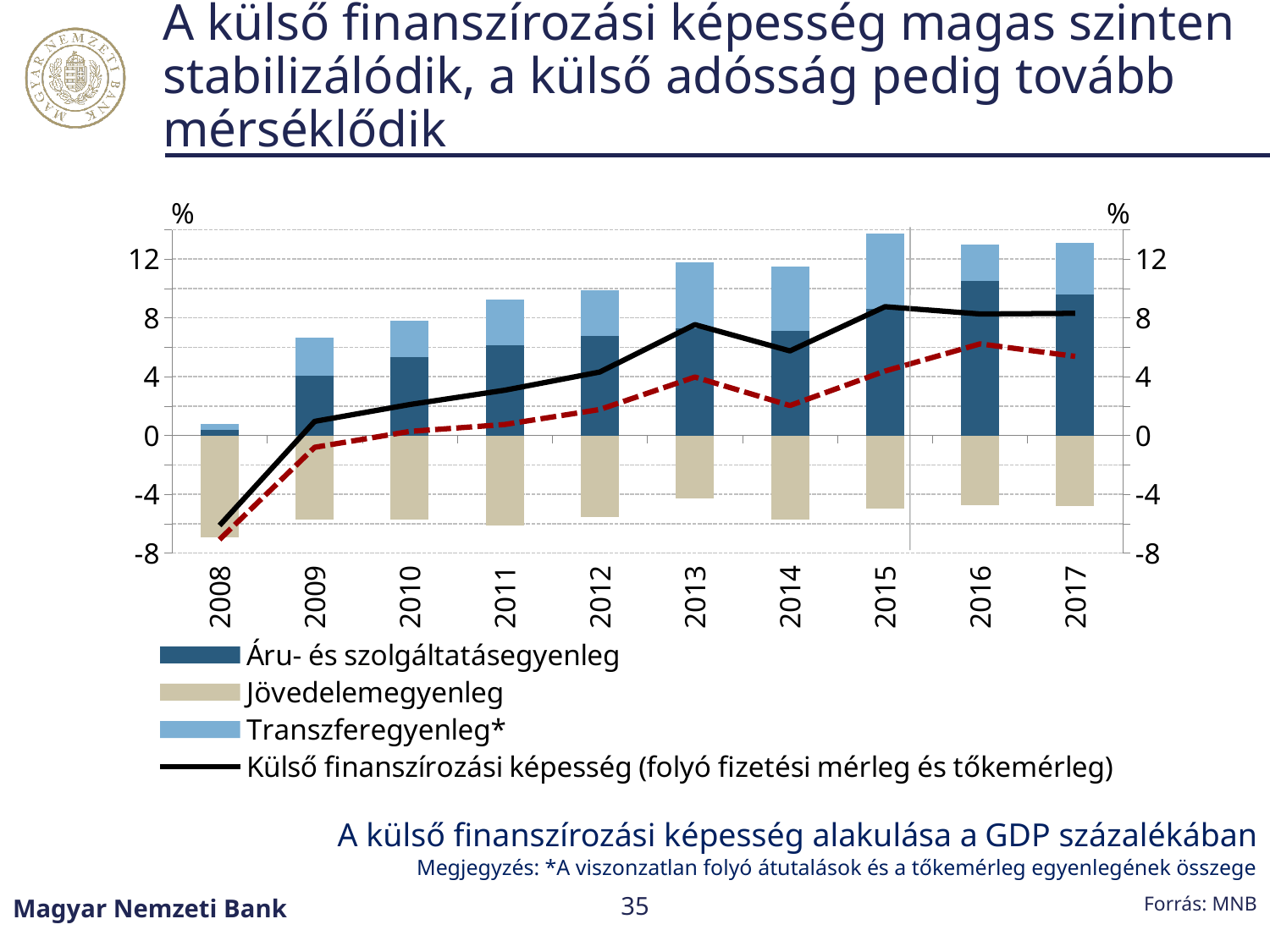
What unit is shown on the vertical axes of the chart? % Is the Jövedelemegyenleg value in 2008 greater or less than -4? less Is the value of Külső finanszírozási képesség in 2014 greater or less than 4? greater Is the value of Külső finanszírozási képesség in 2008 greater or less than -4? less In which year is the Külső finanszírozási képesség line at its lowest? 2008 Does the Külső finanszírozási képesség line rise or fall from 2008 to 2015? rise How many series does the chart legend list? 4 What kind of chart is shown on the slide? Stacked bar chart with lines Which year has the higher Külső finanszírozási képesség value, 2012 or 2013? 2013 How many years are shown on the x axis of the chart? 10